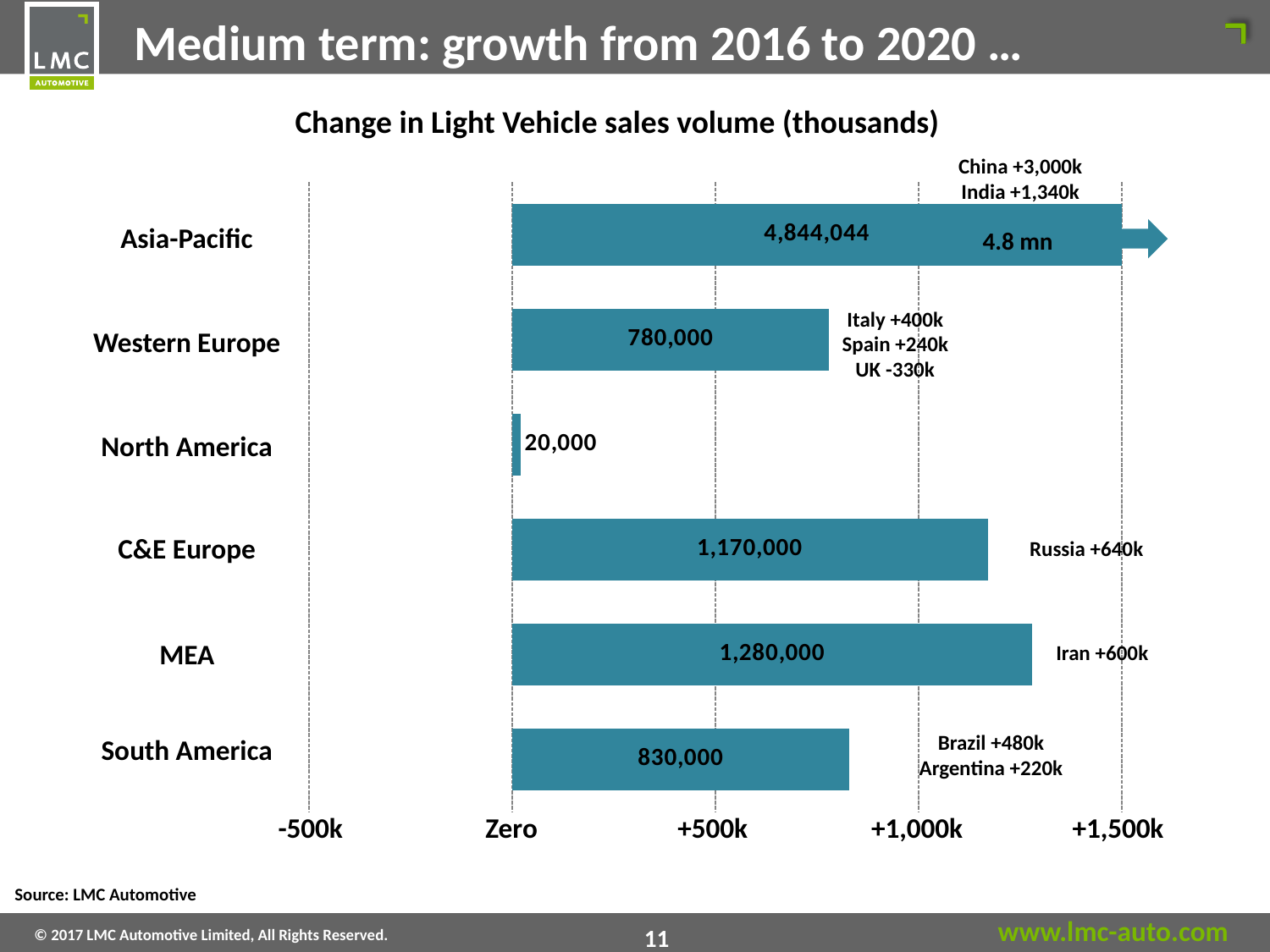
What kind of chart is shown on the slide? Bar chart What is the data label shown for Western Europe? 780,000 How many regions are shown in the chart? 6 Which region has the smallest change in Light Vehicle sales volume? North America What is the data label shown for South America? 830,000 What is the title of the chart? Change in Light Vehicle sales volume (thousands) Is the value for C&E Europe greater or less than +1,000k on the axis? greater Which region has the largest change in Light Vehicle sales volume? Asia-Pacific Which is larger, the value for South America or the value for Western Europe? South America What is the data label shown for MEA? 1,280,000 What is the data label shown for North America? 20,000 What is the difference between the data labels for MEA and C&E Europe? 110,000